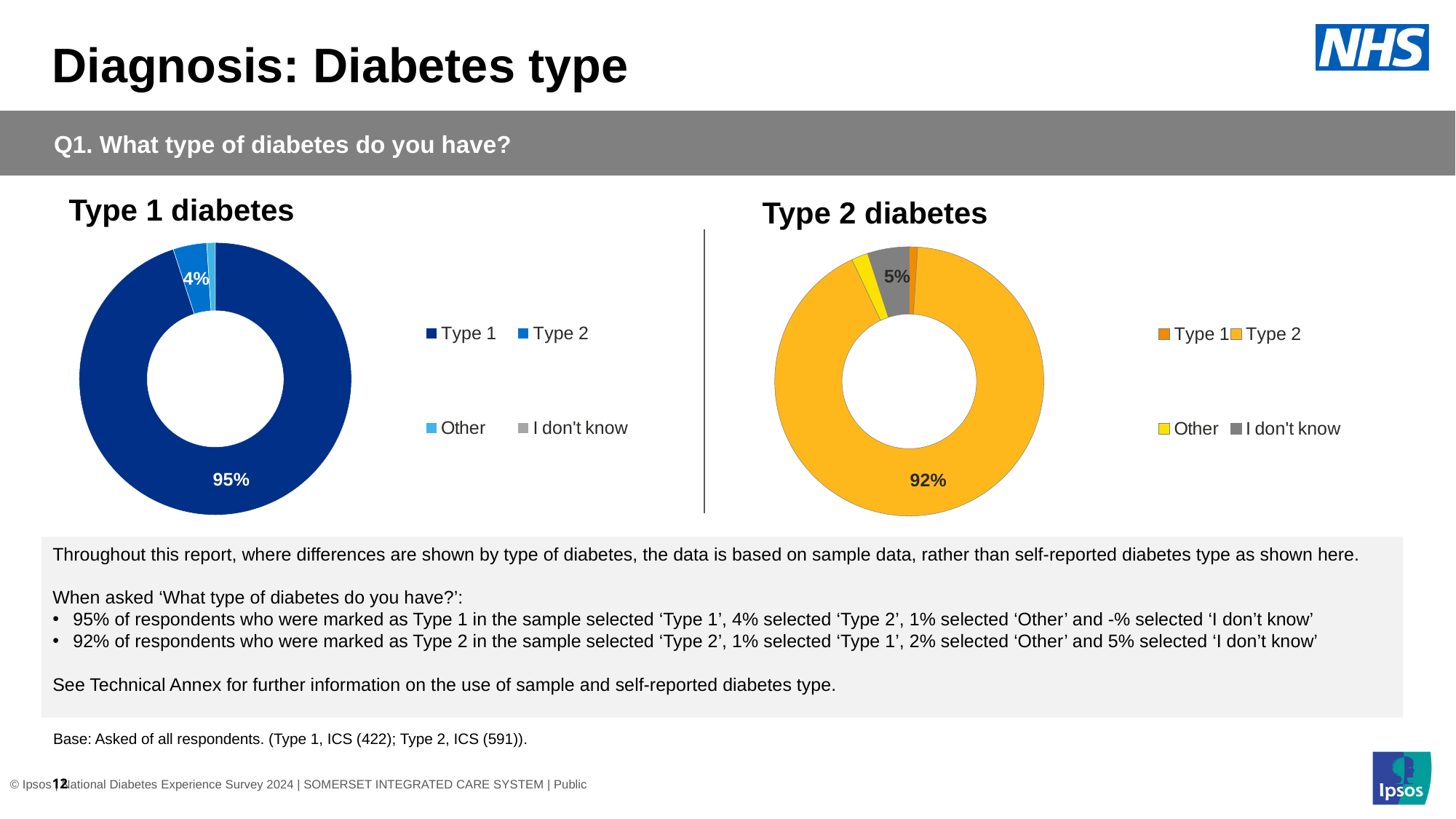
In the Type 1 diabetes chart, what percentage of respondents selected 'Type 2'? 4% In the Type 1 diabetes chart, what colour represents the 'Type 1' category? Dark blue What kind of chart is used to show the Type 1 diabetes results? Pie (donut) chart In the Type 1 diabetes chart, which category has the largest share? Type 1 In the Type 2 diabetes chart, what is the difference in percentage points between the 'Type 2' and 'I don't know' shares? 87 percentage points In the Type 1 diabetes chart, what is the difference in percentage points between the 'Type 1' and 'Type 2' shares? 91 percentage points In the Type 1 diabetes chart, what percentage of respondents selected 'Type 1'? 95% How many categories does the legend of the Type 2 diabetes chart list? 4 In the Type 2 diabetes chart, what percentage of respondents selected 'I don't know'? 5% In the Type 2 diabetes chart, what percentage of respondents selected 'Type 2'? 92% Which is larger: the 'Type 1' share in the Type 1 diabetes chart or the 'Type 2' share in the Type 2 diabetes chart? The 'Type 1' share in the Type 1 diabetes chart (95%) In the Type 2 diabetes chart, which category has the largest share? Type 2